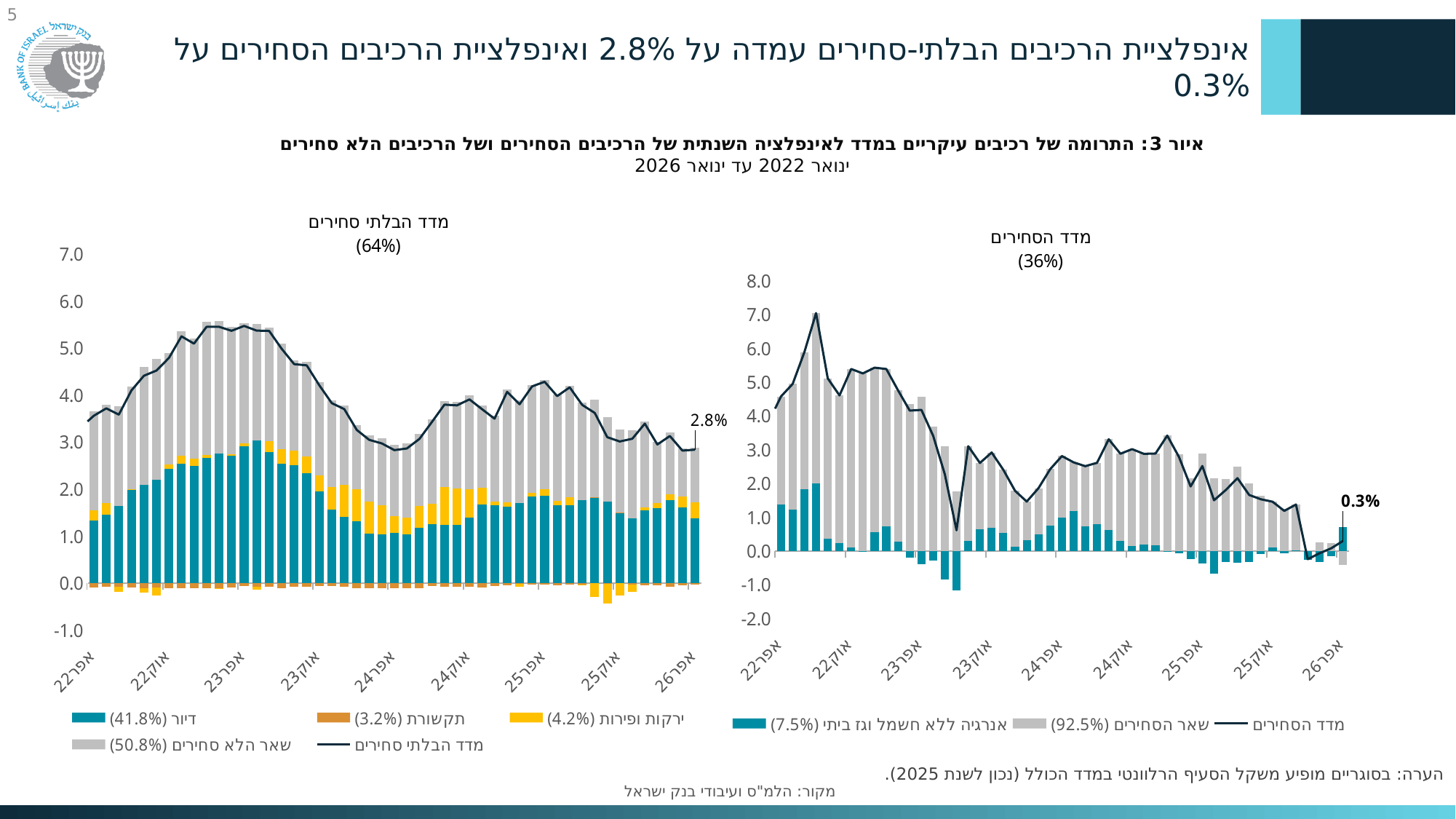
How many entries does the legend of the left chart (מדד הבלתי סחירים) list? 5 What kind of chart is the left chart (מדד הבלתי סחירים)? Stacked bar chart with a line How many entries does the legend of the right chart (מדד הסחירים) list? 3 On the right chart (מדד הסחירים), is the peak of the line in 2022 greater or less than 6.0? greater Which is larger at January 2026: the labelled value on the left chart (מדד הבלתי סחירים) or on the right chart (מדד הסחירים)? Left chart (מדד הבלתי סחירים), 2.8% On the left chart (מדד הבלתי סחירים), is the line value at אפר'22 greater or less than 4.0? less On the right chart (מדד הסחירים), does the line overall rise or fall from 2022 to 2026? fall According to the legend of the left chart, what weight is shown for דיור? 41.8% What weight is shown in the title of the left chart (מדד הבלתי סחירים)? 64% On the right chart (מדד הסחירים), what is the value labelled at the end of the line for January 2026? 0.3% On the left chart (מדד הבלתי סחירים), what is the value labelled at the end of the line for January 2026? 2.8% What is the difference between the labelled January 2026 values on the left chart (2.8%) and the right chart (0.3%)? 2.5 percentage points